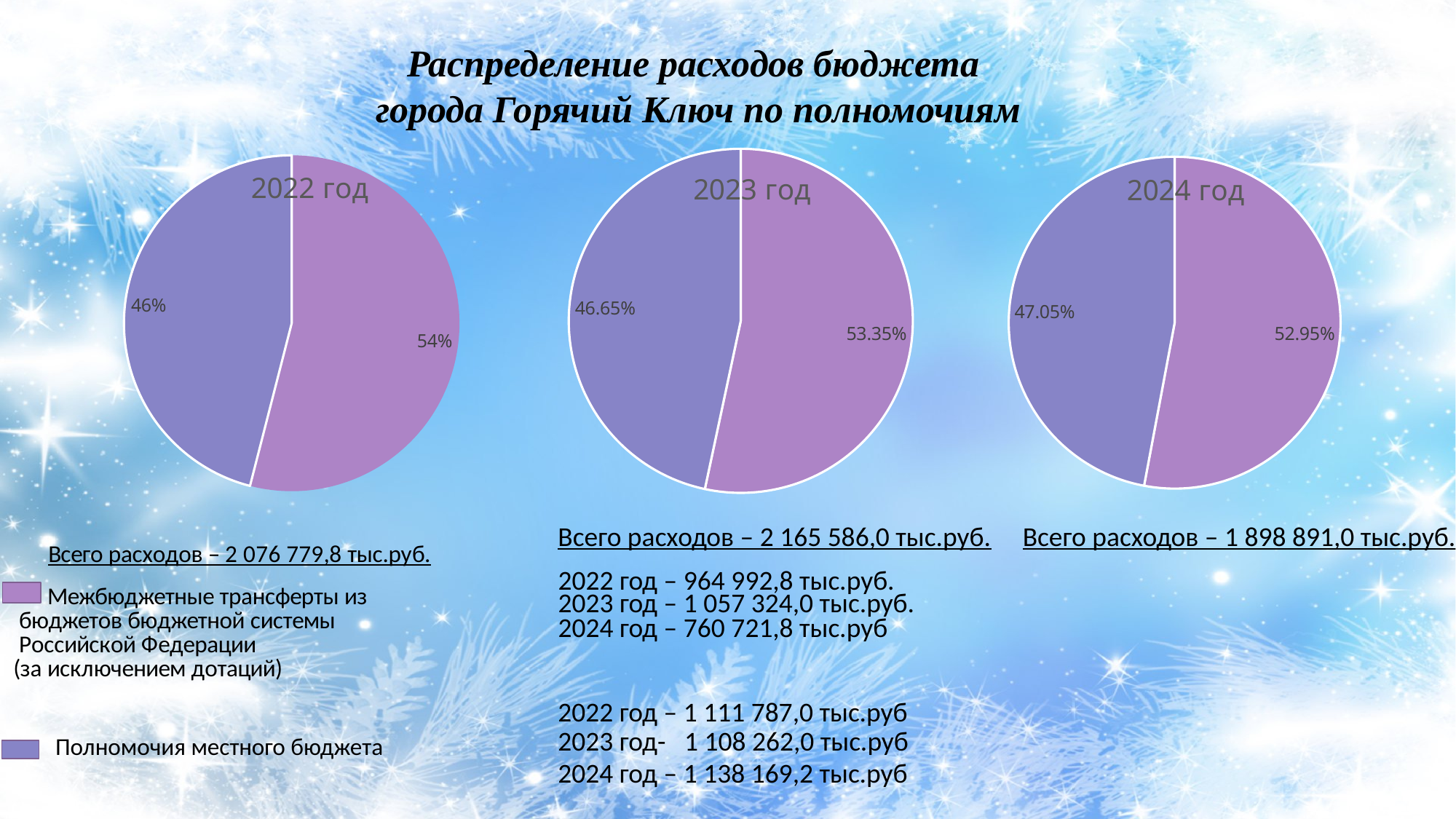
In the 2022 год pie chart, which slice is larger, the pink one or the blue-purple one? the pink one How many pie charts are on the slide? 3 In the 2023 год pie chart, what share does the blue-purple slice have? 46.65% How many slices does each pie chart have? 2 What kind of chart is used for the 2022 год chart? pie chart According to the legend, which category does the blue-purple colour represent? Полномочия местного бюджета In the 2024 год pie chart, what share does the blue-purple slice have? 47.05% In the 2022 год pie chart, what share does the blue-purple slice (Полномочия местного бюджета) have? 46% In the 2024 год pie chart, what is the difference between the pink slice and the blue-purple slice? 5.90%